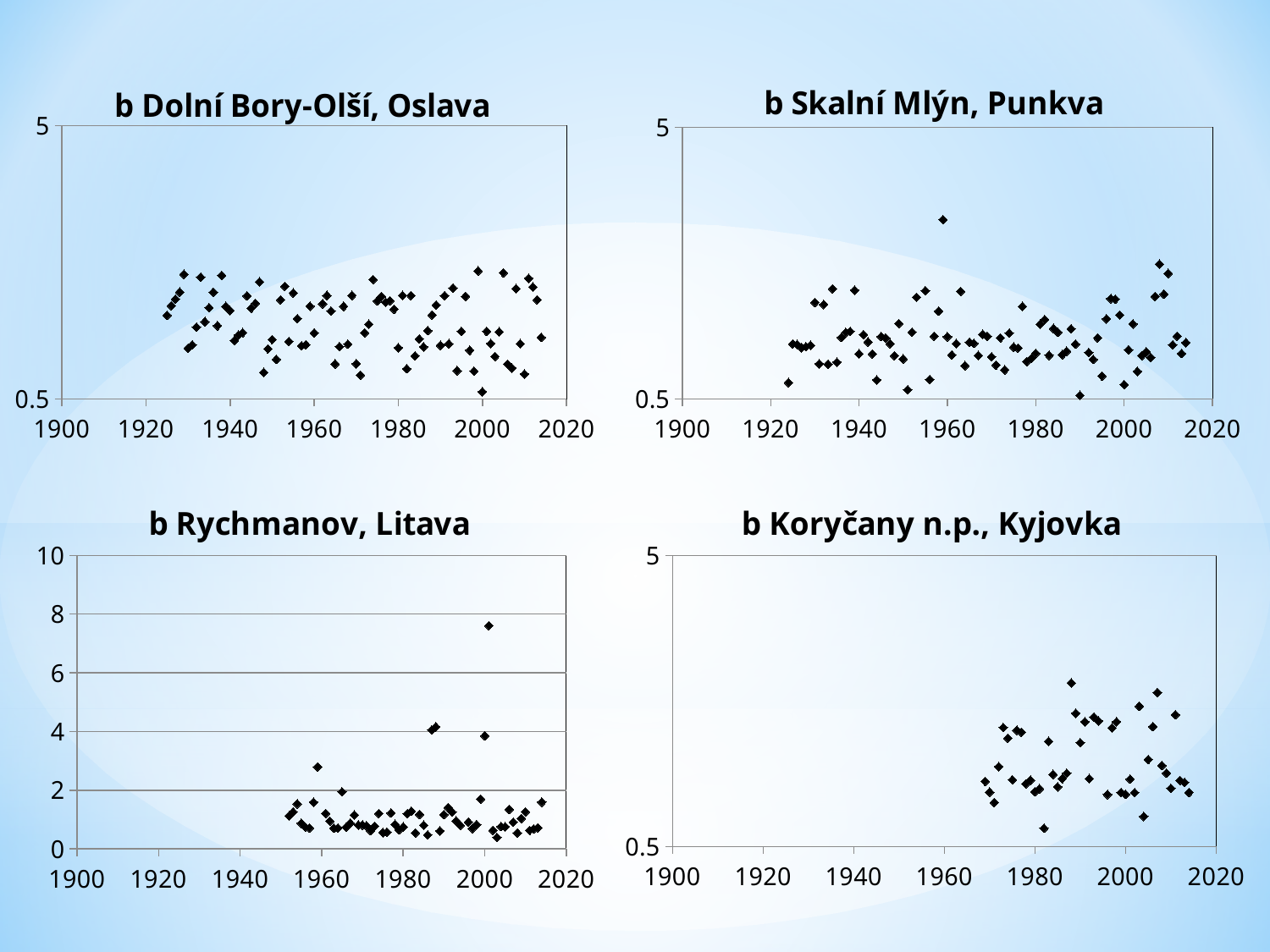
Which chart on the slide has a y axis that goes up to 10? b Rychmanov, Litava In the b Koryčany n.p., Kyjovka chart, do the plotted points begin before or after 1960 on the x axis? after How many charts are shown on the slide? 4 In the b Rychmanov, Litava chart, are the majority of the plotted points greater or less than 2? less What is the title of the top-left chart? b Dolní Bory-Olší, Oslava What kind of chart is the b Koryčany n.p., Kyjovka chart? scatter chart In the b Dolní Bory-Olší, Oslava chart, do the plotted points begin before or after 1940 on the x axis? before What kind of chart is the b Dolní Bory-Olší, Oslava chart? scatter chart